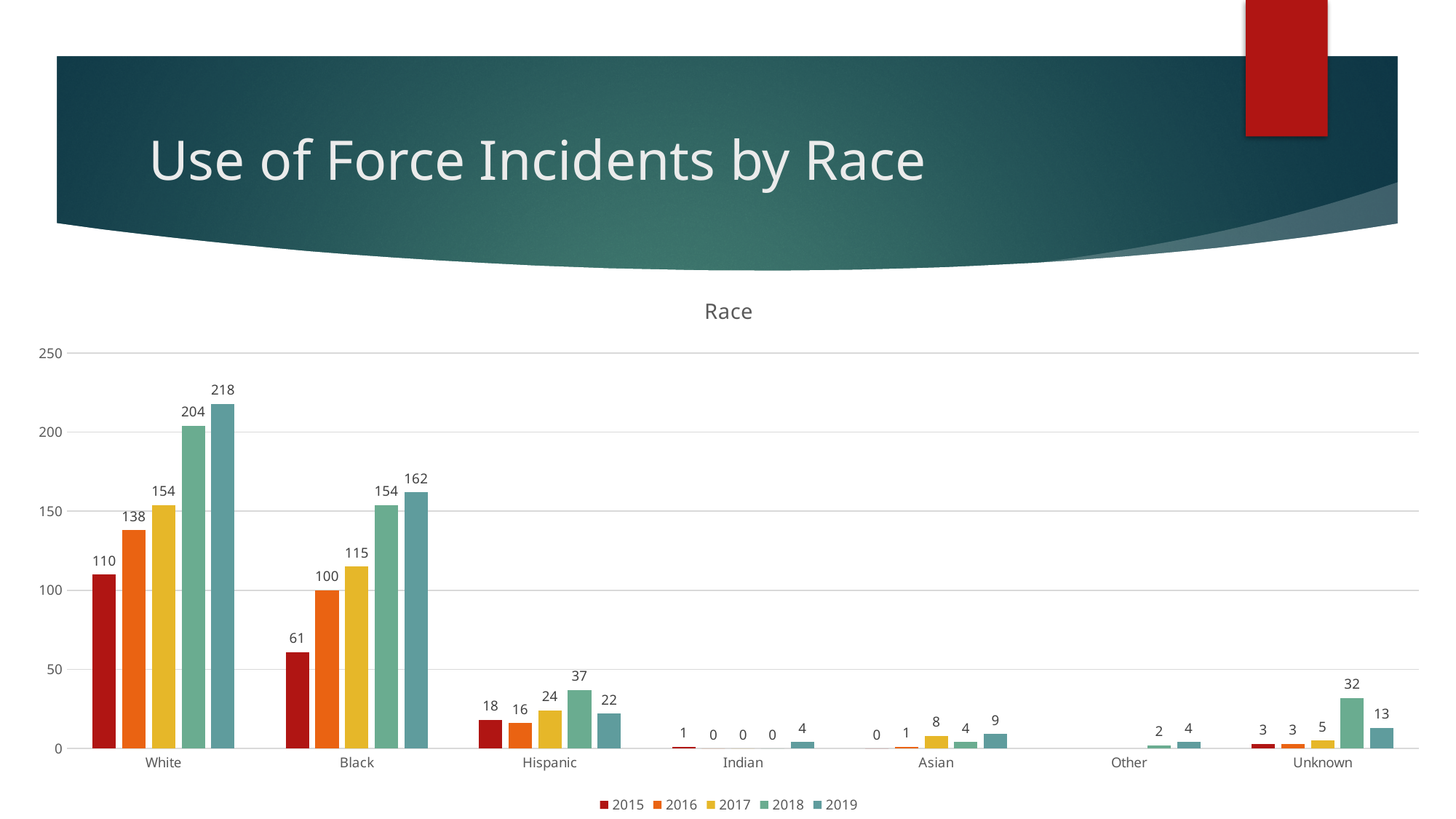
Which is larger, the 2018 value for Black or the 2017 value for White? They are equal (154) How many categories are shown on the x axis? 7 Which year has the highest value for White? 2019 What is the value for Black in 2015? 61 How many series does the legend list? 5 Do the values for Black rise or fall from 2015 to 2019? rise What is the value for Hispanic in 2018? 37 Which year has the lowest value for Black? 2015 What is the value for Unknown in 2018? 32 What is the value for White in 2019? 218 What type of chart is shown on the slide? bar chart What is the difference between the 2019 and 2015 values for White? 108